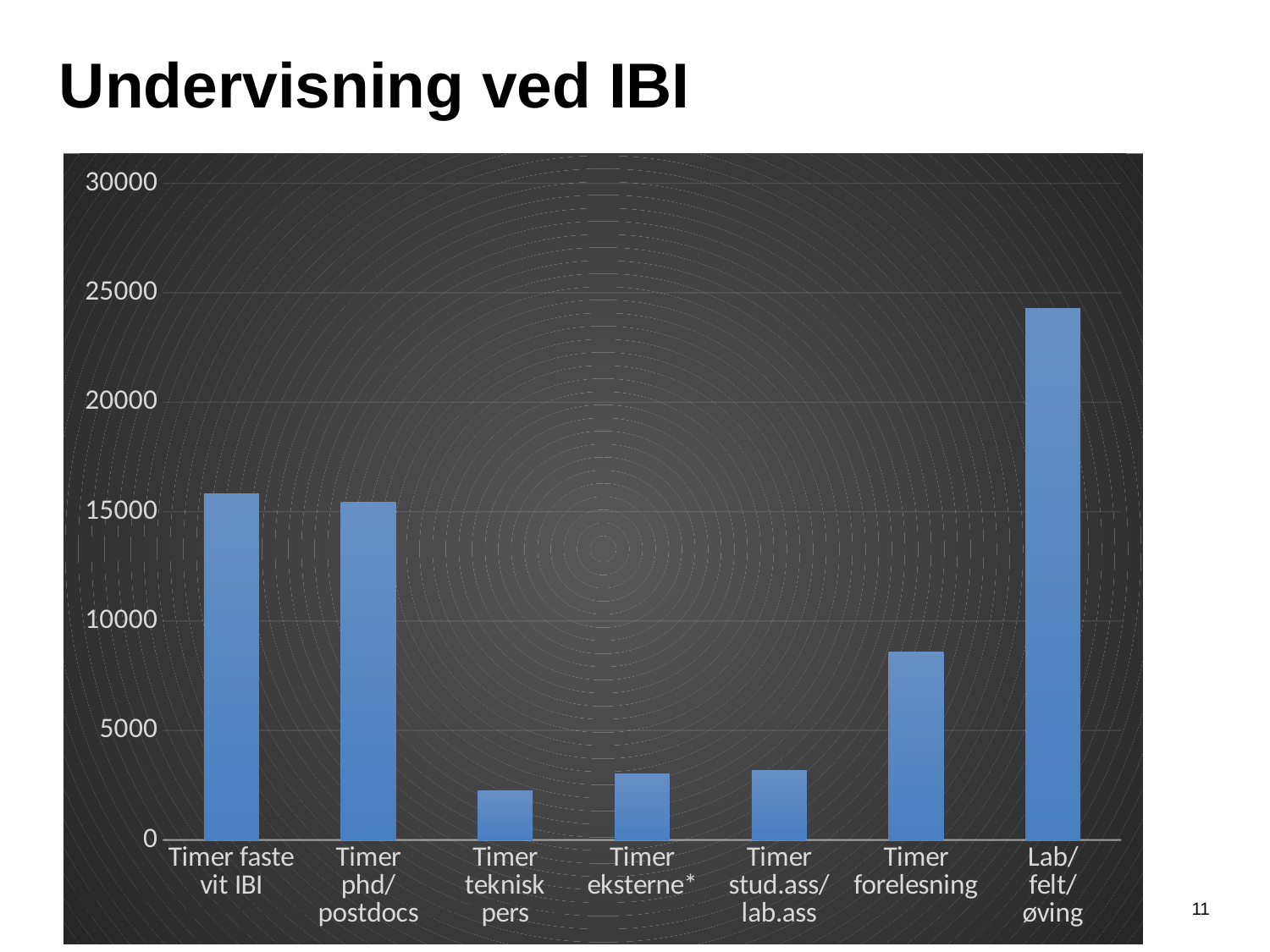
Is the value for Timer teknisk pers greater or less than 5000? less Is the value for Timer faste vit IBI greater or less than 15000? greater What kind of chart is shown on the slide? bar chart Which is larger, the value for Timer forelesning or the value for Timer stud.ass/lab.ass? Timer forelesning What is the title of the slide containing the chart? Undervisning ved IBI Is the value for Timer forelesning greater or less than 5000? greater Which is larger, the value for Lab/felt/øving or the value for Timer faste vit IBI? Lab/felt/øving How many categories are shown on the x axis of the chart? 7 Which category has the highest value in the chart? Lab/felt/øving Which category has the lowest value in the chart? Timer teknisk pers